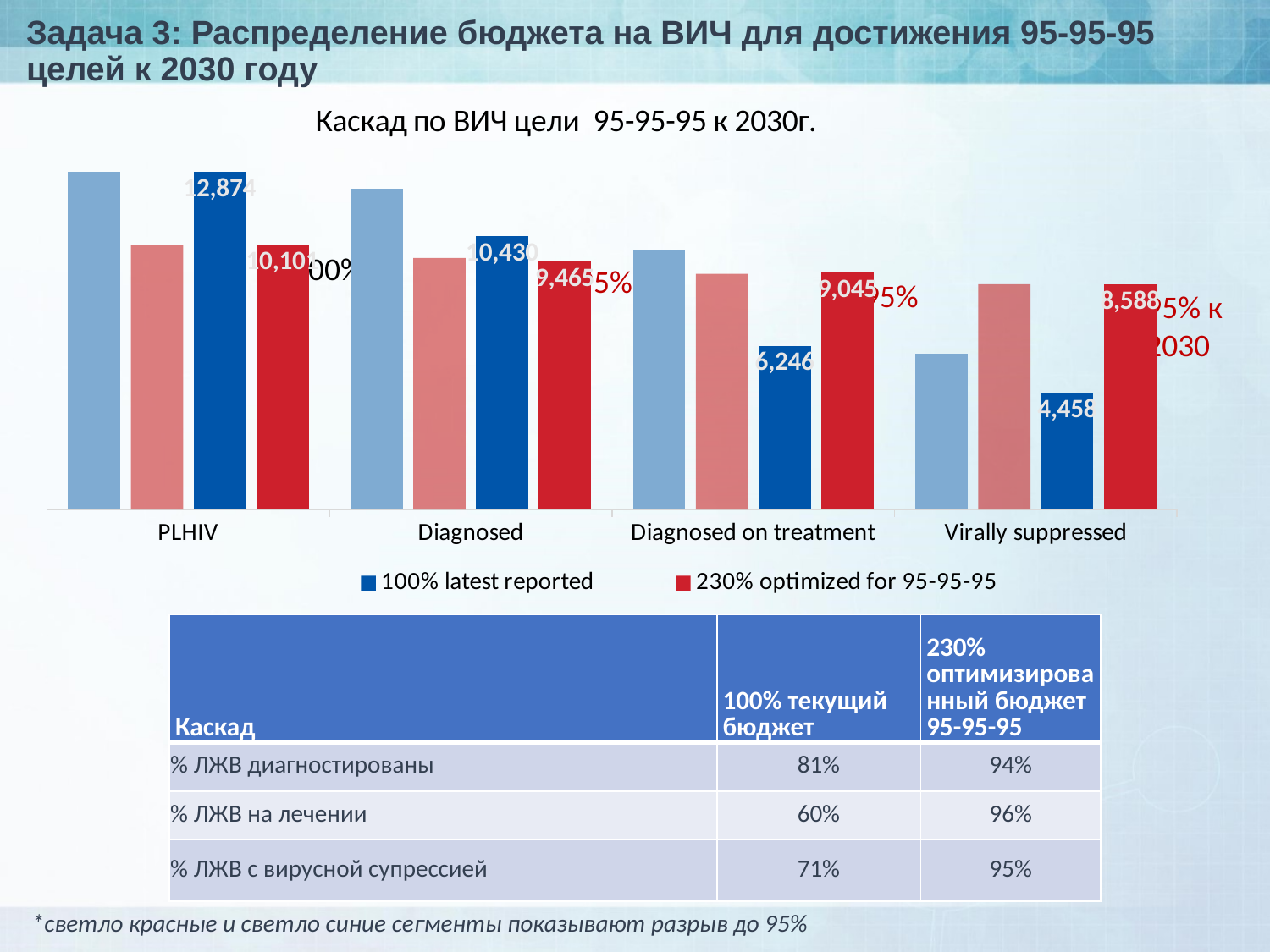
Which category has the lowest value in the '100% latest reported' series? Virally suppressed What is the value of the '100% latest reported' series for Diagnosed on treatment? 6,246 What is the value of the '100% latest reported' series for PLHIV? 12,874 Which category has the highest value in the '100% latest reported' series? PLHIV For Diagnosed on treatment, which series has the larger value: '100% latest reported' or '230% optimized for 95-95-95'? 230% optimized for 95-95-95 What is the value of the '100% latest reported' series for Virally suppressed? 4,458 How many categories are shown on the x axis of the chart? 4 What is the value of the '230% optimized for 95-95-95' series for Diagnosed? 9,465 For Diagnosed, what is the difference between the '100% latest reported' value and the '230% optimized for 95-95-95' value? 965 What is the value of the '100% latest reported' series for Diagnosed? 10,430 What type of chart is shown on the slide? Bar chart How many series does the chart legend list? 2